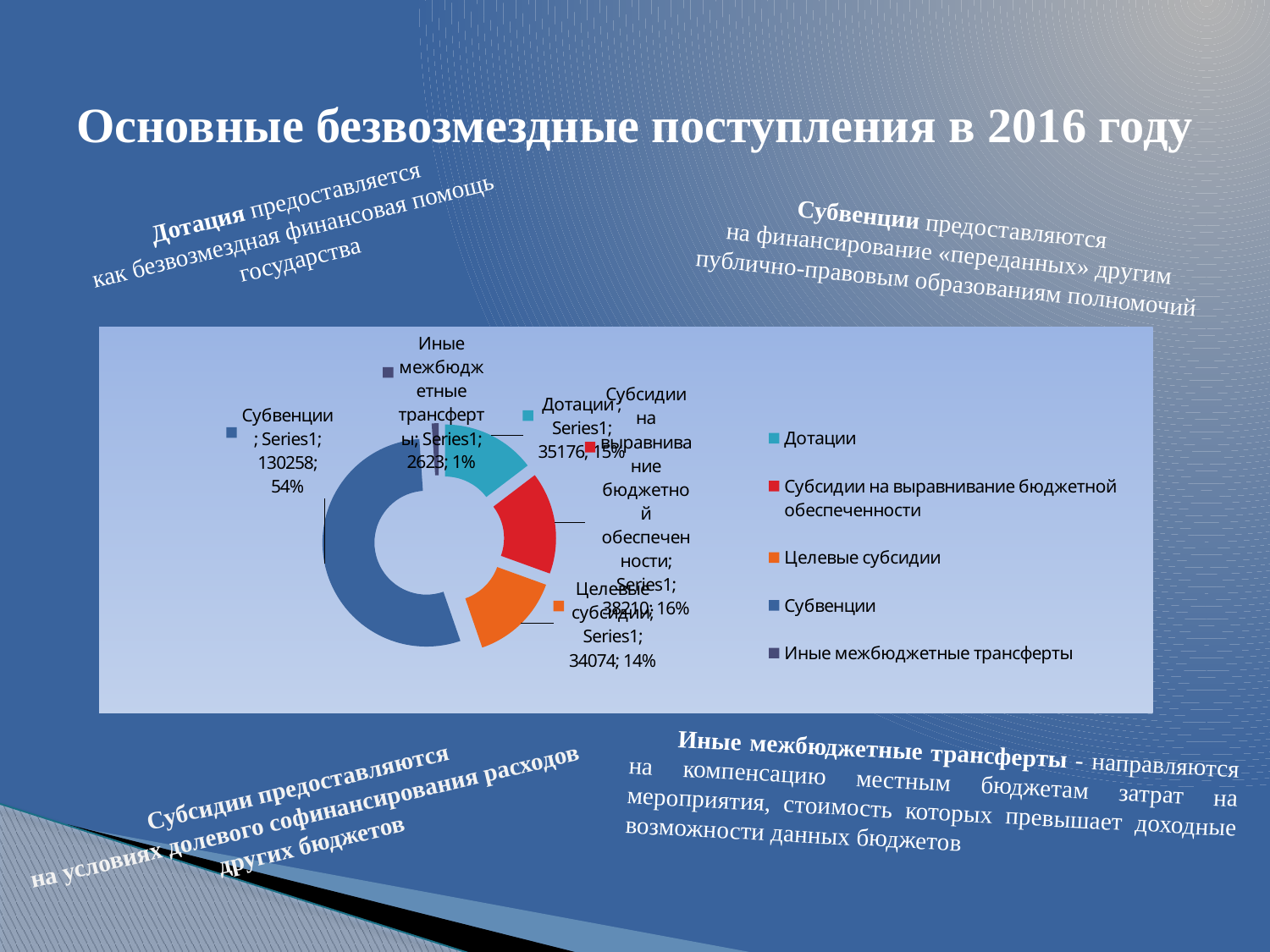
Which category has the largest share in the chart? Субвенции What is the difference between the values for Субвенции and Дотации? 95082 How many categories does the chart show? 5 What colour represents Субвенции in the chart legend? Blue Which is larger: the value for Субсидии на выравнивание бюджетной обеспеченности or the value for Целевые субсидии? Субсидии на выравнивание бюджетной обеспеченности What value is shown for Субвенции on the chart? 130258 What value is shown for Дотации on the chart? 35176 What value is shown for Иные межбюджетные трансферты on the chart? 2623 What percentage share does Субвенции have in the chart? 54% What percentage share does Целевые субсидии have in the chart? 14% What kind of chart is shown on the slide? Doughnut chart Which category has the smallest share in the chart? Иные межбюджетные трансферты